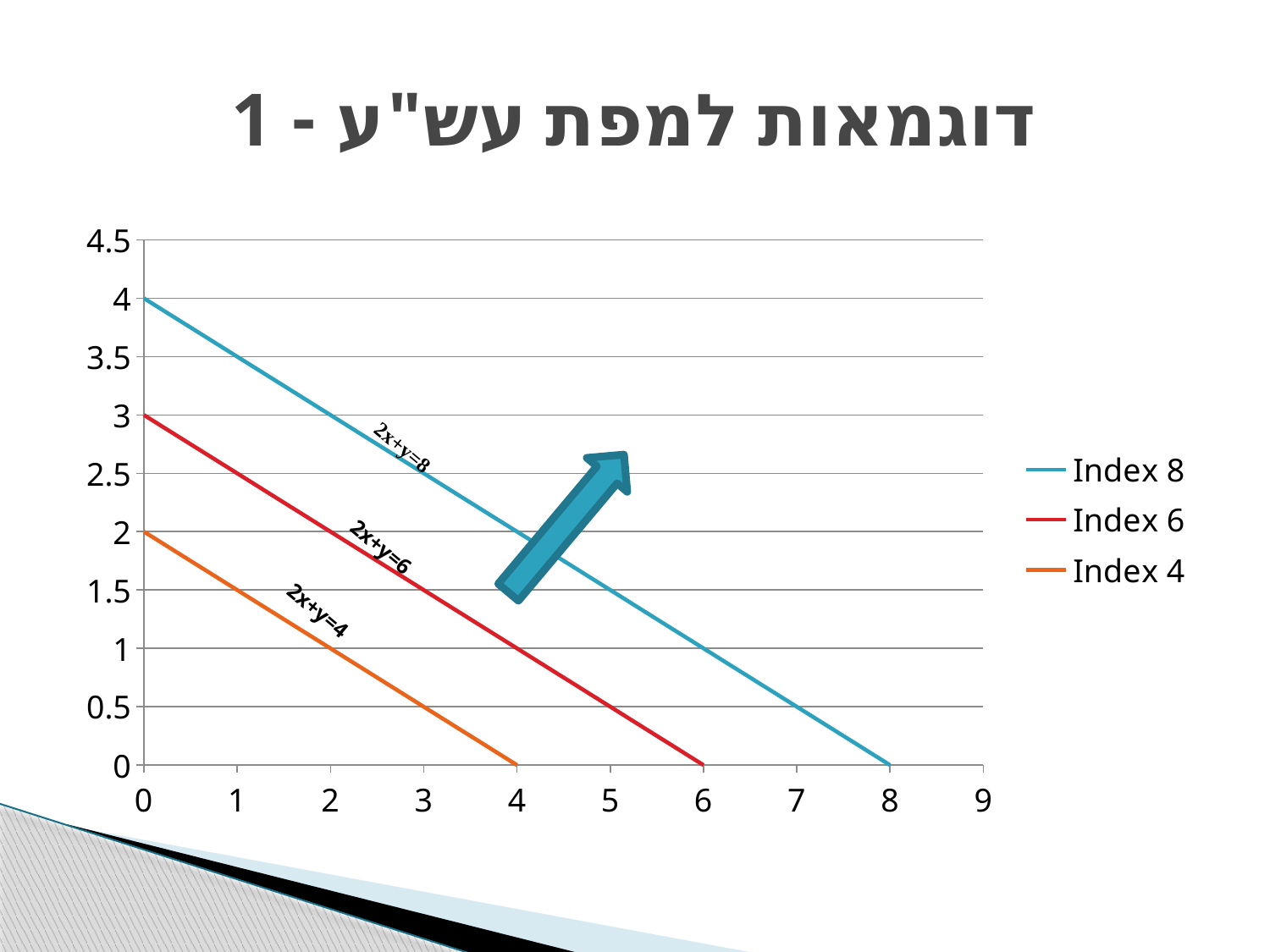
What kind of chart is shown on the slide? line chart Which series has the lowest y value at x = 0? Index 4 What colour is the Index 6 line? red How many series does the legend list? 3 Do the lines rise or fall as x increases? fall At x = 0, what is the y value of the Index 4 line? 2 Which series has the highest y value at x = 0? Index 8 At what x value does the Index 6 line reach y = 0? 6 What are the series names listed in the legend? Index 8, Index 6, Index 4 What is the difference between the y values of Index 8 and Index 6 at x = 0? 1 At x = 0, what is the y value of the Index 8 line? 4 At what x value does the Index 8 line reach y = 0? 8